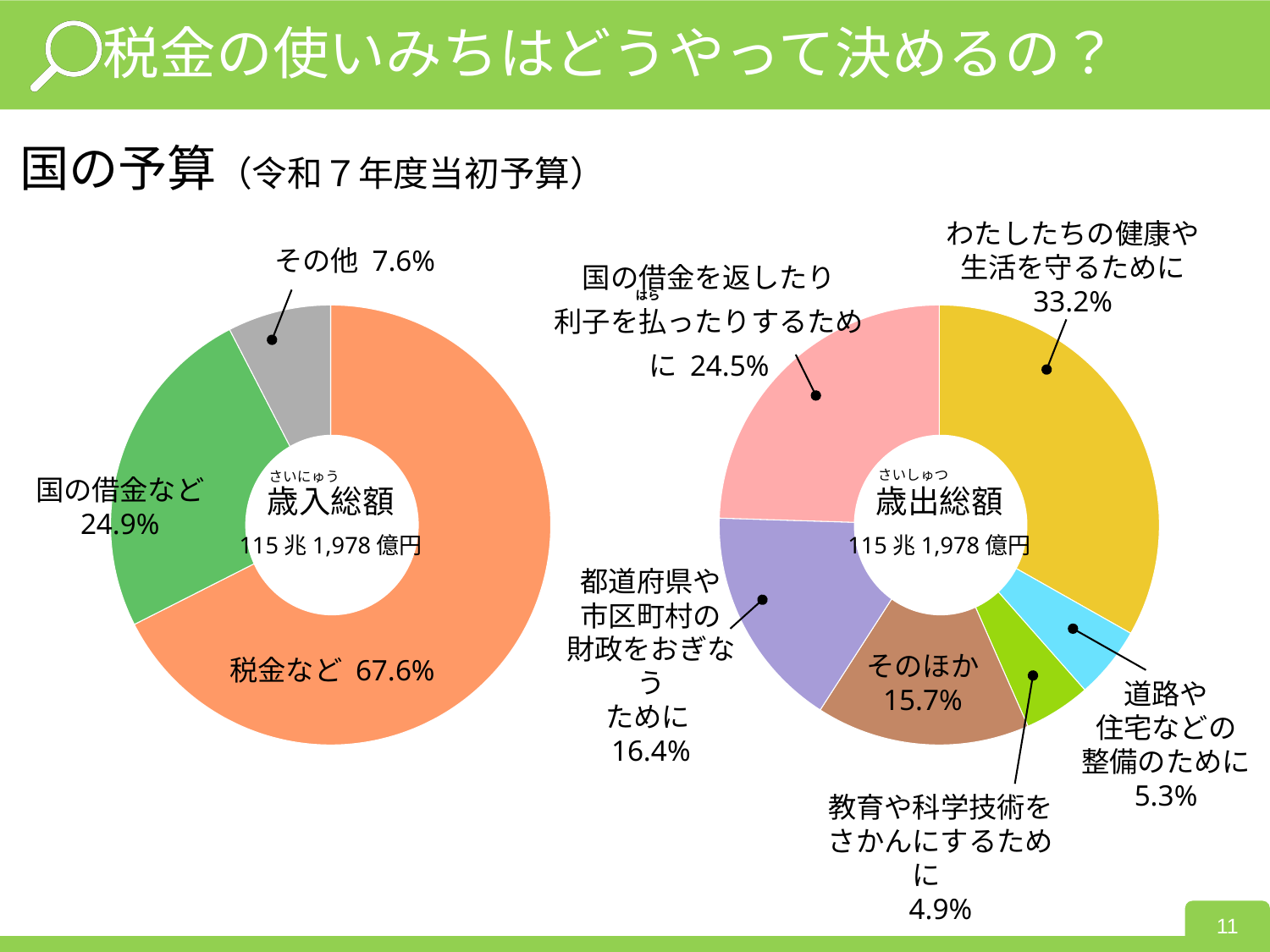
What type of chart is used for the 歳入総額 chart on the left? Donut (pie) chart In the 歳出総額 chart on the right, what share is labelled for 教育や科学技術をさかんにするために? 4.9% In the 歳入総額 chart on the left, how many categories are shown? 3 In the 歳入総額 chart on the left, which category has the smallest share? その他 In the 歳出総額 chart on the right, which is larger: the share for 都道府県や市区町村の財政をおぎなうために or the share for そのほか? 都道府県や市区町村の財政をおぎなうために In the 歳出総額 chart on the right, which category has the smallest share? 教育や科学技術をさかんにするために In the 歳入総額 chart on the left, what is the difference between the shares for 税金など and 国の借金など? 42.7% In the 歳出総額 chart on the right, which category has the largest share? わたしたちの健康や生活を守るために In the 歳出総額 chart on the right, what share is labelled for わたしたちの健康や生活を守るために? 33.2% In the 歳入総額 chart on the left, what share is labelled for 税金など? 67.6% In the 歳入総額 chart on the left, what share is labelled for 国の借金など? 24.9% In the 歳出総額 chart on the right, how many categories are shown? 6